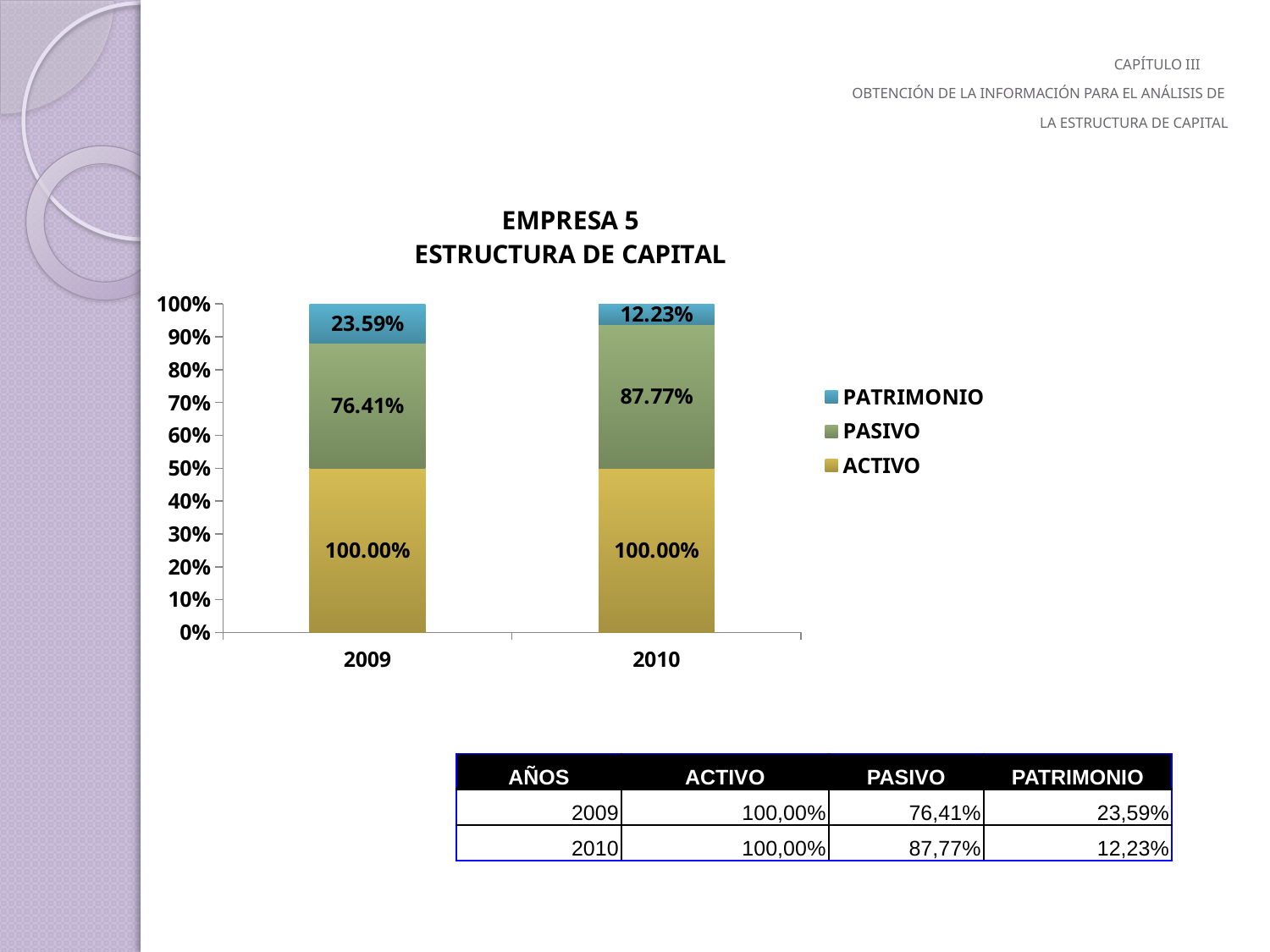
What is the PASIVO value for 2010? 87.77% Which year has the higher PASIVO value? 2010 Which year has the lower PATRIMONIO value? 2010 Does the PATRIMONIO value rise or fall from 2009 to 2010? Fall How many series does the legend list? 3 What is the PATRIMONIO value for 2009? 23.59% What is the difference between the PASIVO values for 2010 and 2009? 11.36% What is the ACTIVO value for 2010? 100.00% Is the PATRIMONIO value for 2009 larger than the PATRIMONIO value for 2010? Yes How many years are shown on the x axis? 2 What kind of chart is shown? Stacked bar chart What is the PATRIMONIO value for 2010? 12.23%